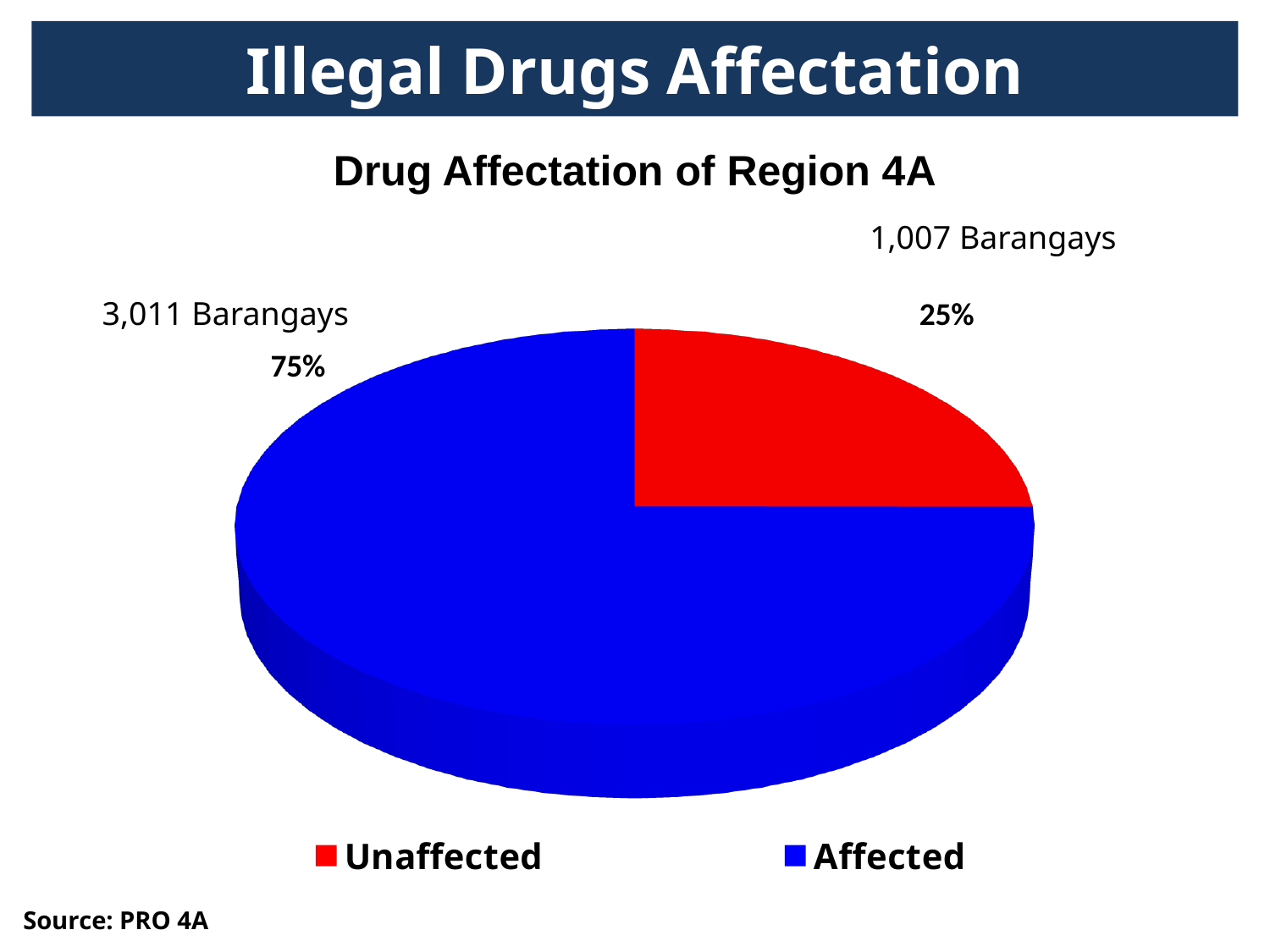
What is the title of the chart? Drug Affectation of Region 4A What share of the pie does the Affected slice represent? 75% What is the difference in the number of barangays between Affected and Unaffected? 2,004 Barangays What share of the pie does the Unaffected slice represent? 25% How many barangays are shown as Affected? 3,011 Barangays What kind of chart is shown on the slide? Pie chart Which category has the smallest slice in the pie? Unaffected How many categories does the pie chart have? 2 Which colour represents the Unaffected category in the legend? Red How many barangays are shown as Unaffected? 1,007 Barangays Which category has the larger slice, Affected or Unaffected? Affected What is the total number of barangays represented in the pie chart? 4,018 Barangays